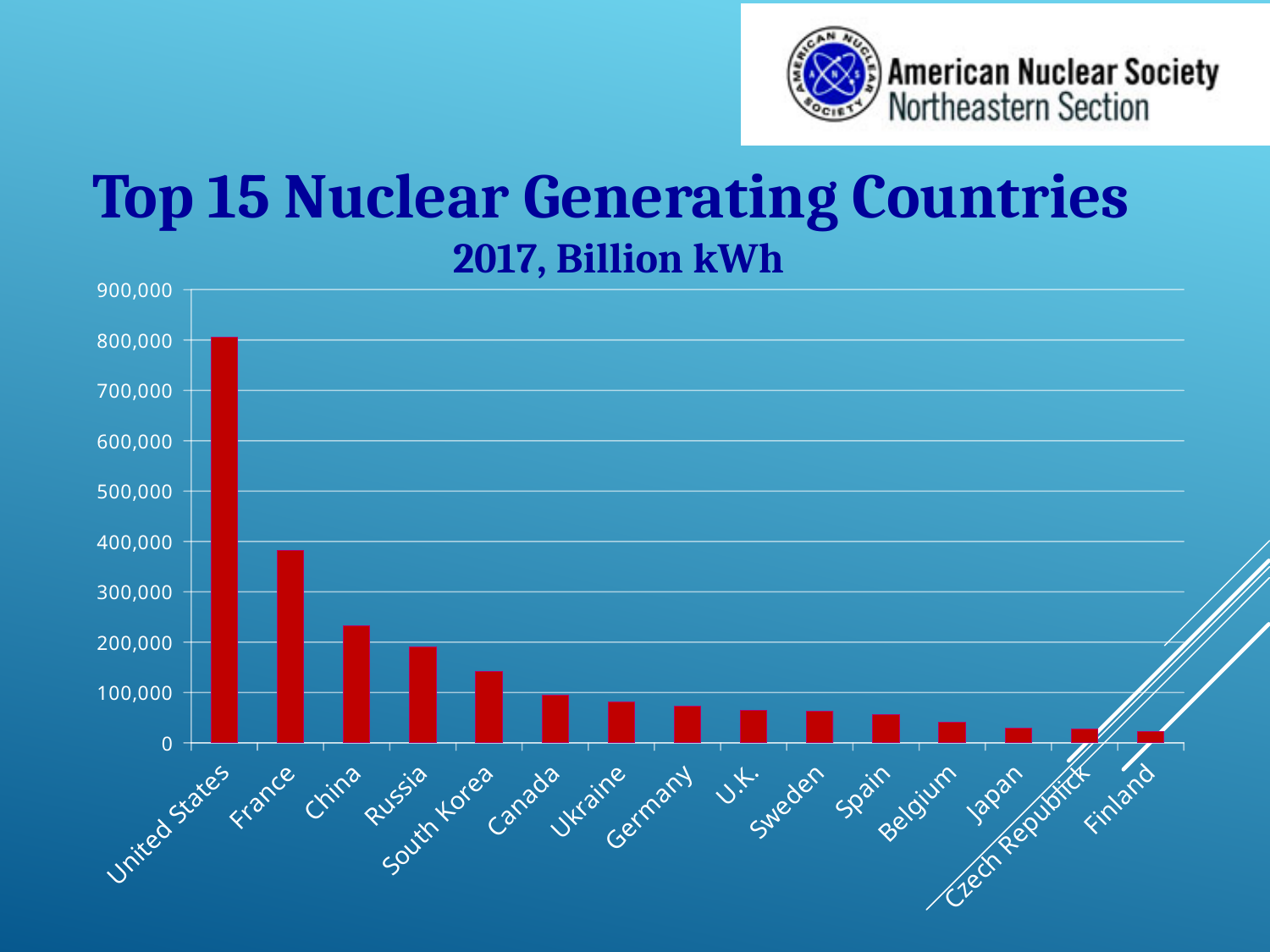
Which has a larger value, China or Russia? China Do the values rise or fall moving from left to right along the x axis? fall Is the value for South Korea greater or less than 100,000? greater Which country has the lowest nuclear generation on the chart? Finland How many countries are shown on the chart? 15 Is the value for Belgium greater or less than 100,000? less Which country has the highest nuclear generation on the chart? United States Is the value for China greater or less than 200,000? greater What year and unit does the chart subtitle give? 2017, Billion kWh What kind of chart is shown on the slide? bar chart